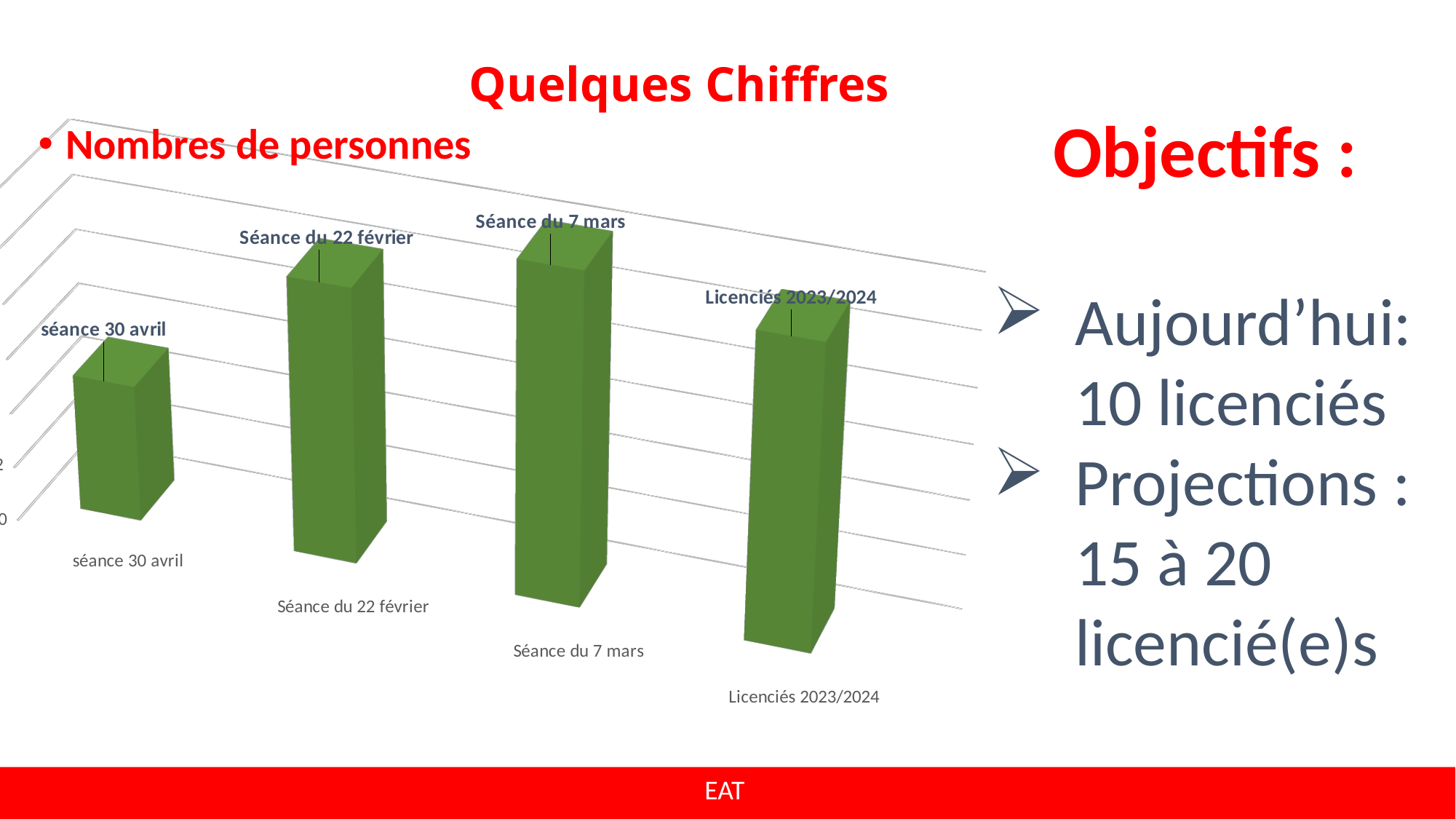
What colour are the bars in the chart? green What is the label of the last category on the x axis of the chart? Licenciés 2023/2024 Which is larger, the value for Licenciés 2023/2024 or the value for séance 30 avril? Licenciés 2023/2024 Which is larger, the value for Séance du 7 mars or the value for Séance du 22 février? Séance du 7 mars Which is larger, the value for Séance du 7 mars or the value for séance 30 avril? Séance du 7 mars What kind of chart is shown on the slide? bar chart How many categories are plotted in the chart? 4 Which category has the lowest value in the chart? séance 30 avril